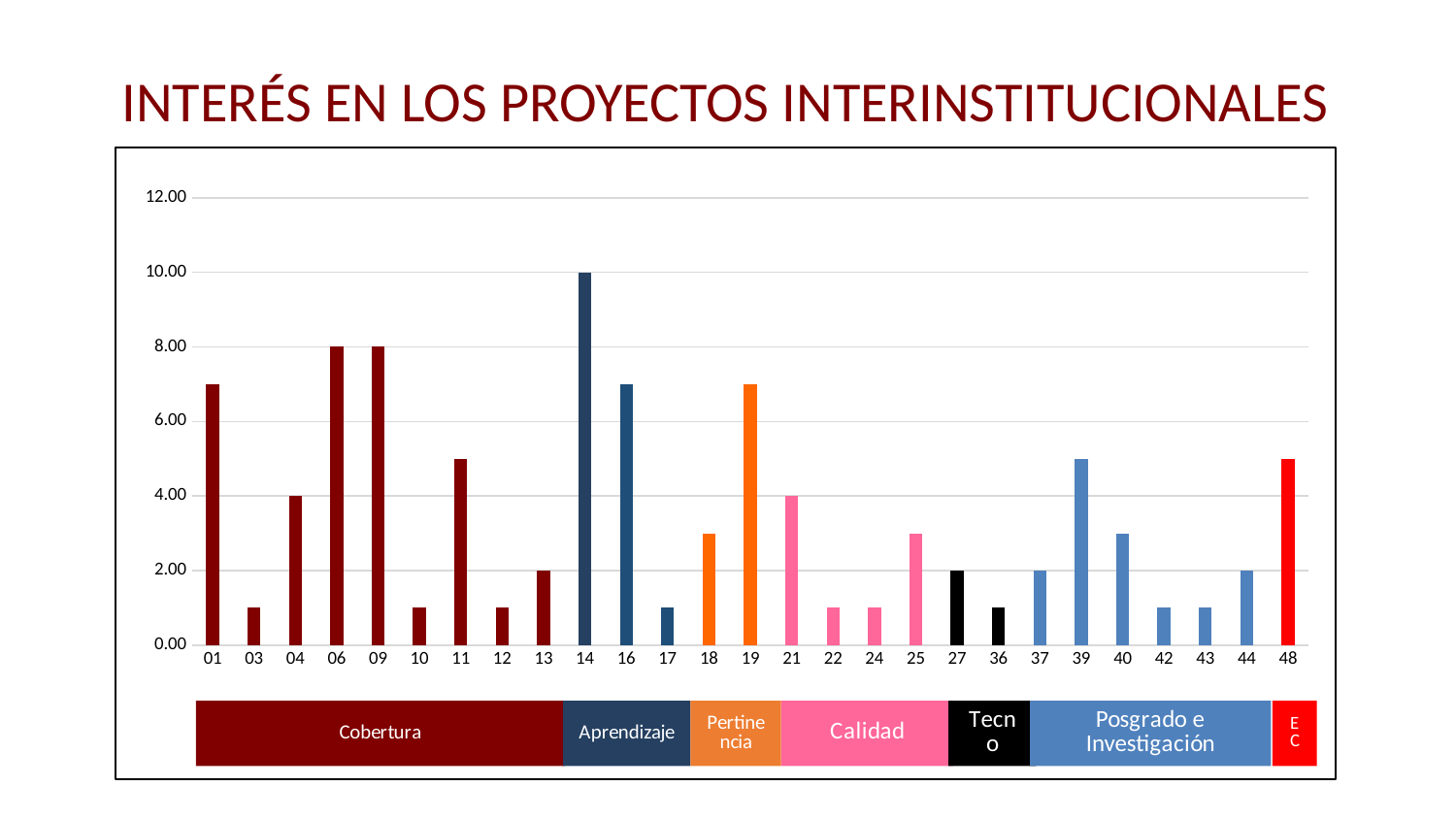
Which group label is shown in red at the far right below the chart? EC What is the value for project 06? 8.00 What is the value for project 14? 10.00 How many projects are shown on the x axis? 27 Which has a larger value, project 01 or project 11? 01 What is the value for project 04? 4.00 Is the value for project 25 greater or less than 4.00? less Is the value for project 19 greater or less than 6.00? greater Which project has the highest value? 14 What is the difference between the values for project 14 and project 09? 2.00 What type of chart is shown on the slide? bar chart What is the value for project 44? 2.00